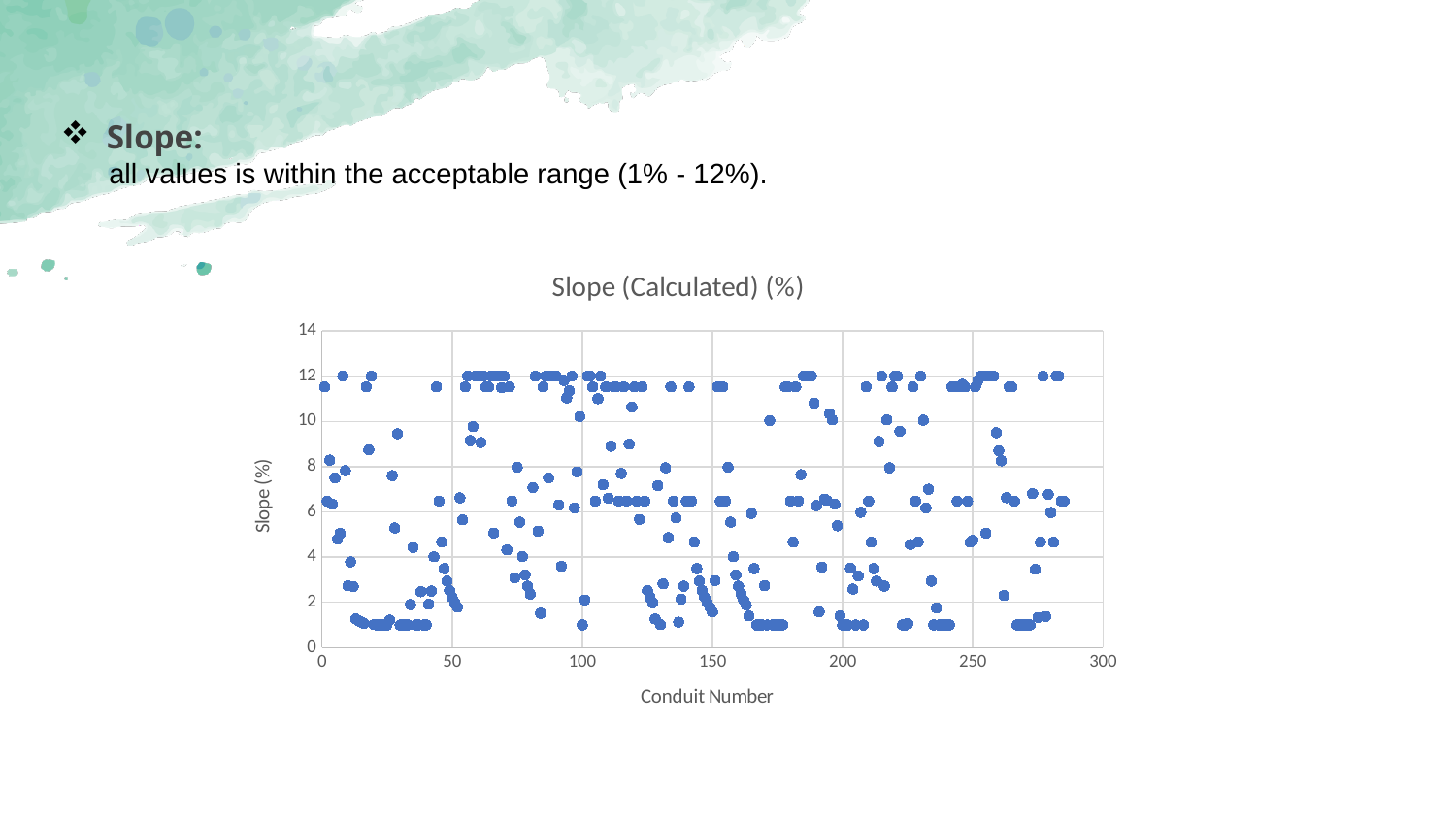
What is the title of the chart? Slope (Calculated) (%) What kind of chart is shown on the slide? Scatter chart Are all plotted slope values less than 14? Yes What is the interval between consecutive tick marks on the x axis? 50 What is the highest slope value plotted on the chart? 12 Are any plotted slope values greater than 12? No What is the interval between consecutive tick marks on the y axis? 2 What is the maximum value shown on the x axis of the chart? 300 What is the label of the x axis of the chart? Conduit Number What is the maximum value shown on the y axis of the chart? 14